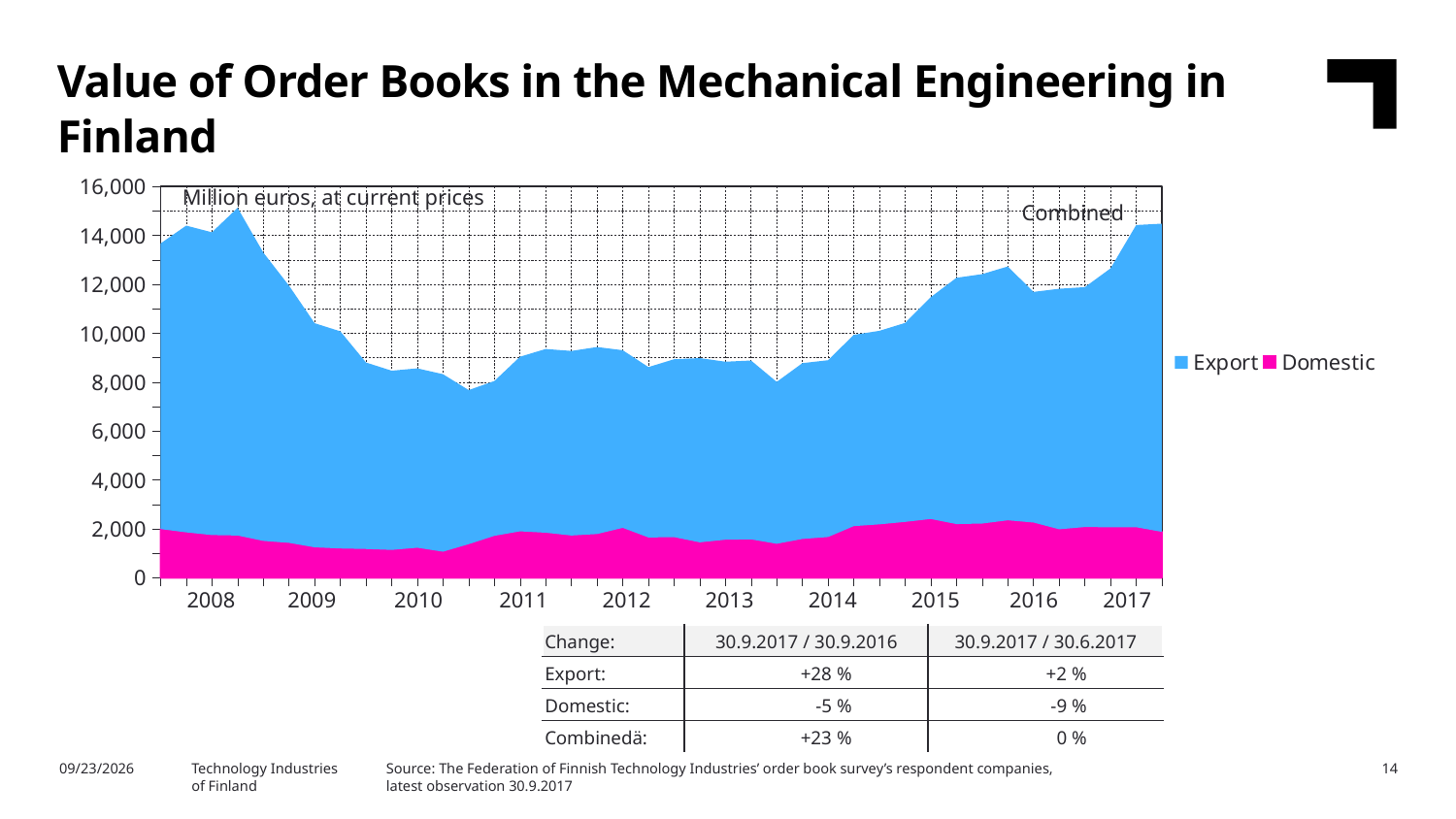
What is the highest value shown on the y axis of the chart? 16,000 What kind of chart is shown on the slide? Stacked area chart Is the combined value of order books at the start of 2008 greater or less than 12,000? greater How many year labels are shown on the x axis of the chart? 10 Which two series are listed in the chart legend? Export and Domestic Which series, Export or Domestic, has the larger value in 2016? Export How many series does the chart legend list? 2 Does the combined value of order books rise or fall from 2008 to 2010? fall Is the combined value of order books at the end of 2017 greater or less than 12,000? greater What unit is stated in the chart's subtitle? Million euros, at current prices Is the Domestic value of order books in 2010 greater or less than 2,000? less